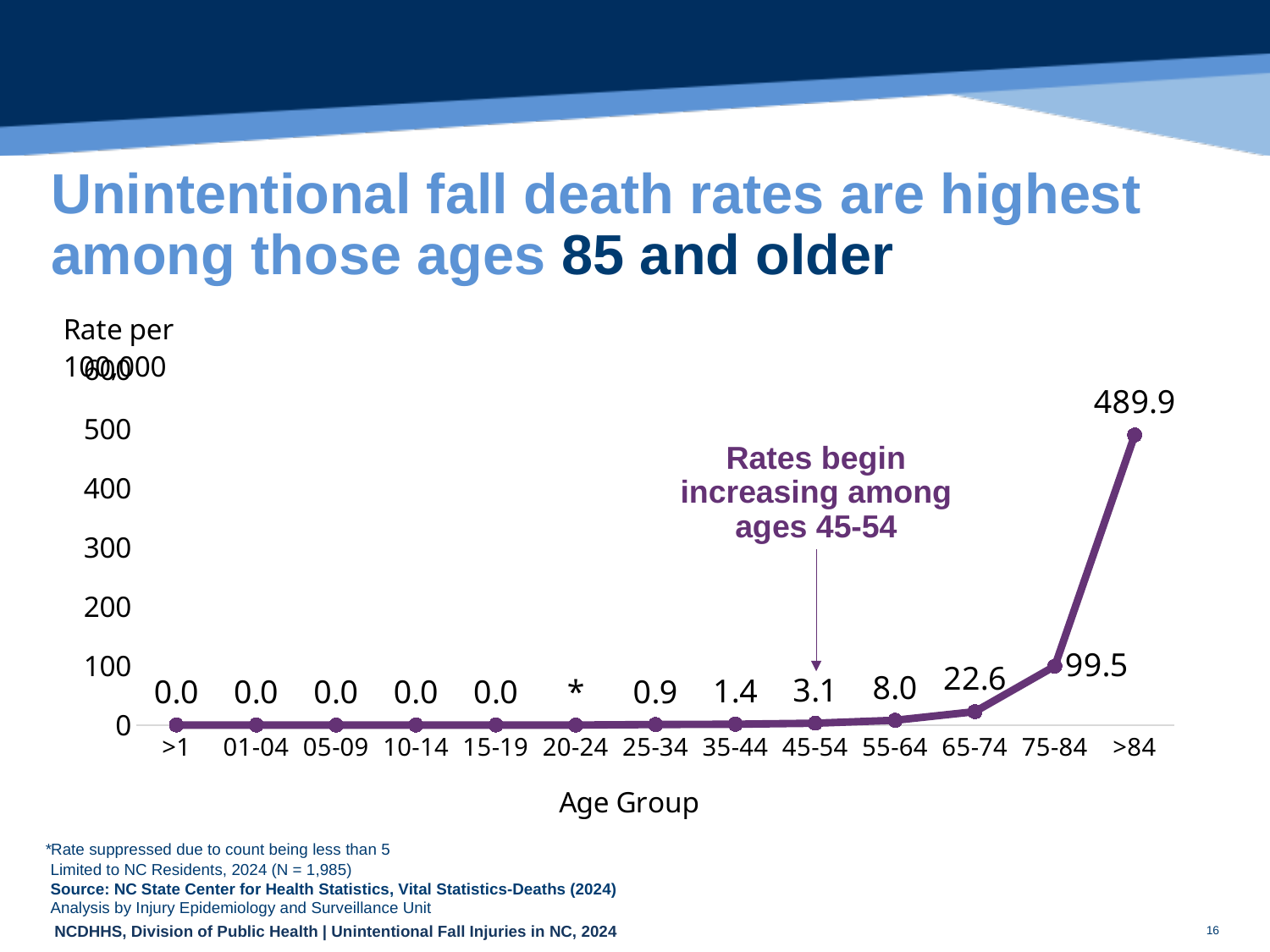
How many age groups are plotted on the x axis? 13 Which age group has the highest unintentional fall death rate? >84 What is the rate per 100,000 for the 75-84 age group? 99.5 What is the difference in rate between the >84 and 75-84 age groups? 390.4 What is the difference in rate between the 65-74 and 55-64 age groups? 14.6 Do the rates rise or fall as age group increases along the x axis? Rise What is the unintentional fall death rate per 100,000 for the >84 age group? 489.9 What type of chart is shown on the slide? Line chart What does the asterisk (*) data label for the 20-24 age group indicate? Rate suppressed due to count being less than 5 What is the rate per 100,000 for the 45-54 age group? 3.1 Which age group has a higher rate, 35-44 or 55-64? 55-64 What is the rate per 100,000 for the 65-74 age group? 22.6